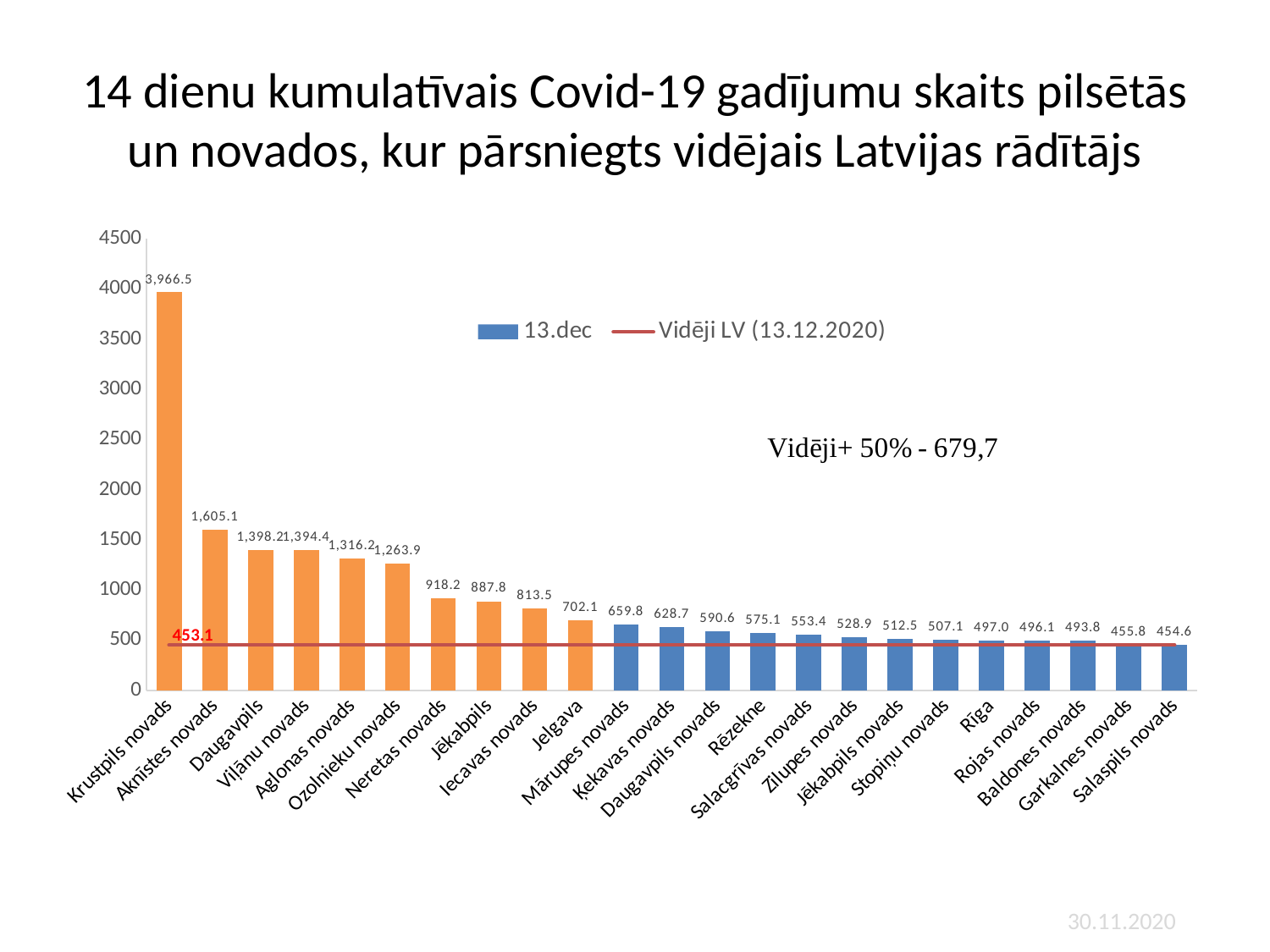
How many entries does the legend list? 2 Which category has the highest value? Krustpils novads What kind of chart is shown on the slide? combination bar and line chart How many cities and districts are shown on the x axis? 23 What value is shown for Rīga? 497.0 Which category has the lowest value? Salaspils novads What is the 14-day cumulative Covid-19 value shown for Krustpils novads? 3,966.5 What is the value of the 'Vidēji LV (13.12.2020)' line? 453.1 Which has a larger value, Neretas novads or Jēkabpils? Neretas novads What value is shown for Jelgava? 702.1 What is the difference between the values for Krustpils novads and Aknīstes novads? 2,361.4 Is the value for Aknīstes novads greater or less than 1500? greater